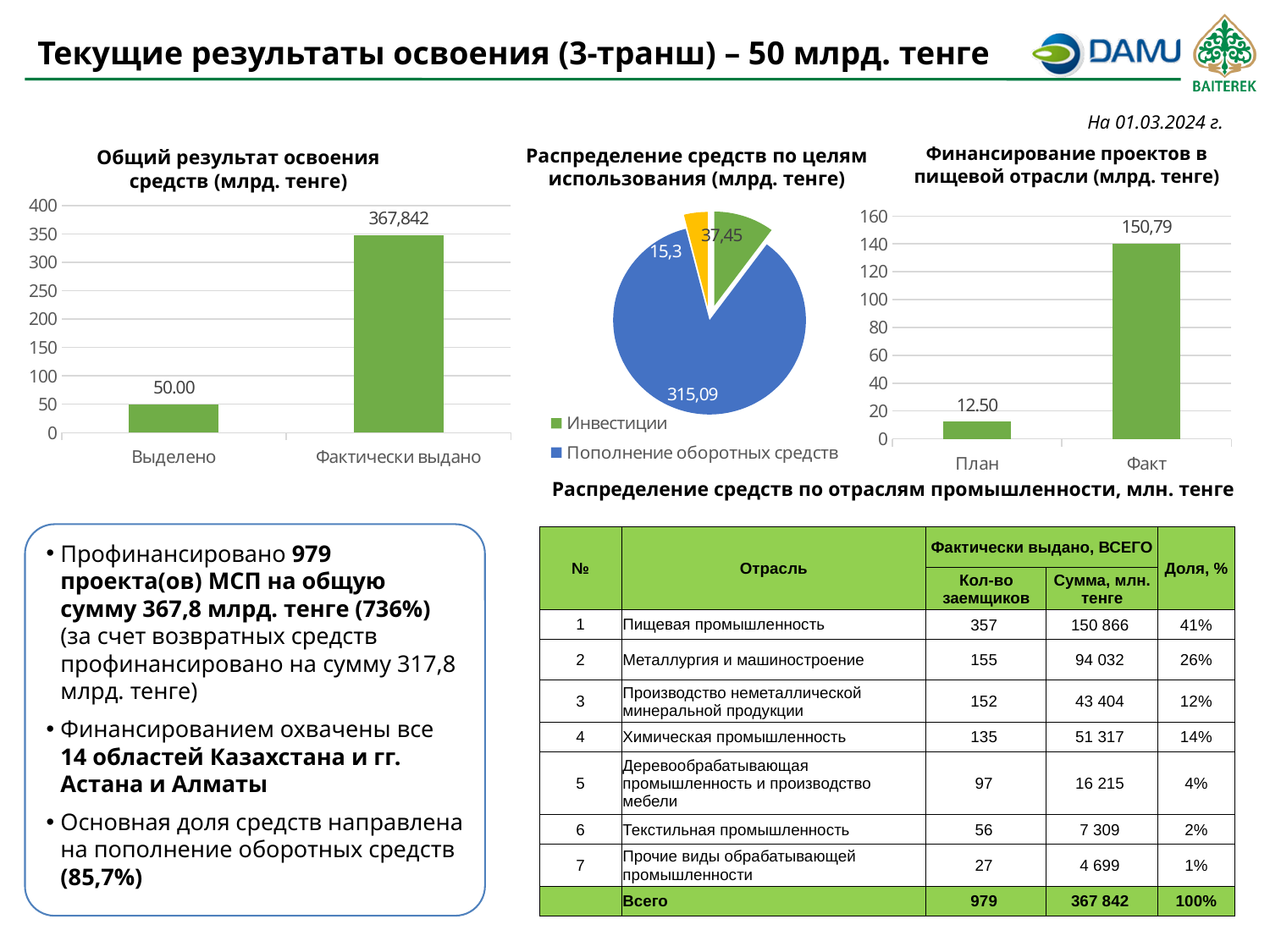
In the chart 'Финансирование проектов в пищевой отрасли (млрд. тенге)', what is the value for 'Факт'? 150,79 In the chart 'Финансирование проектов в пищевой отрасли (млрд. тенге)', what is the value for 'План'? 12.50 What kind of chart is 'Общий результат освоения средств (млрд. тенге)'? Bar chart In the chart 'Общий результат освоения средств (млрд. тенге)', how many categories are shown on the x axis? 2 In the pie chart 'Распределение средств по целям использования (млрд. тенге)', how many entries does the legend list? 2 In the chart 'Финансирование проектов в пищевой отрасли (млрд. тенге)', is the value for 'Факт' greater or less than 140? greater In the chart 'Общий результат освоения средств (млрд. тенге)', what is the value for 'Выделено'? 50.00 What kind of chart is 'Распределение средств по целям использования (млрд. тенге)'? Pie chart In the pie chart 'Распределение средств по целям использования (млрд. тенге)', what is the value of the largest slice? 315,09 In the chart 'Общий результат освоения средств (млрд. тенге)', which category has the higher value? Фактически выдано In the pie chart 'Распределение средств по целям использования (млрд. тенге)', what is the value of the smallest slice? 15,3 In the chart 'Общий результат освоения средств (млрд. тенге)', what is the value for 'Фактически выдано'? 367,842